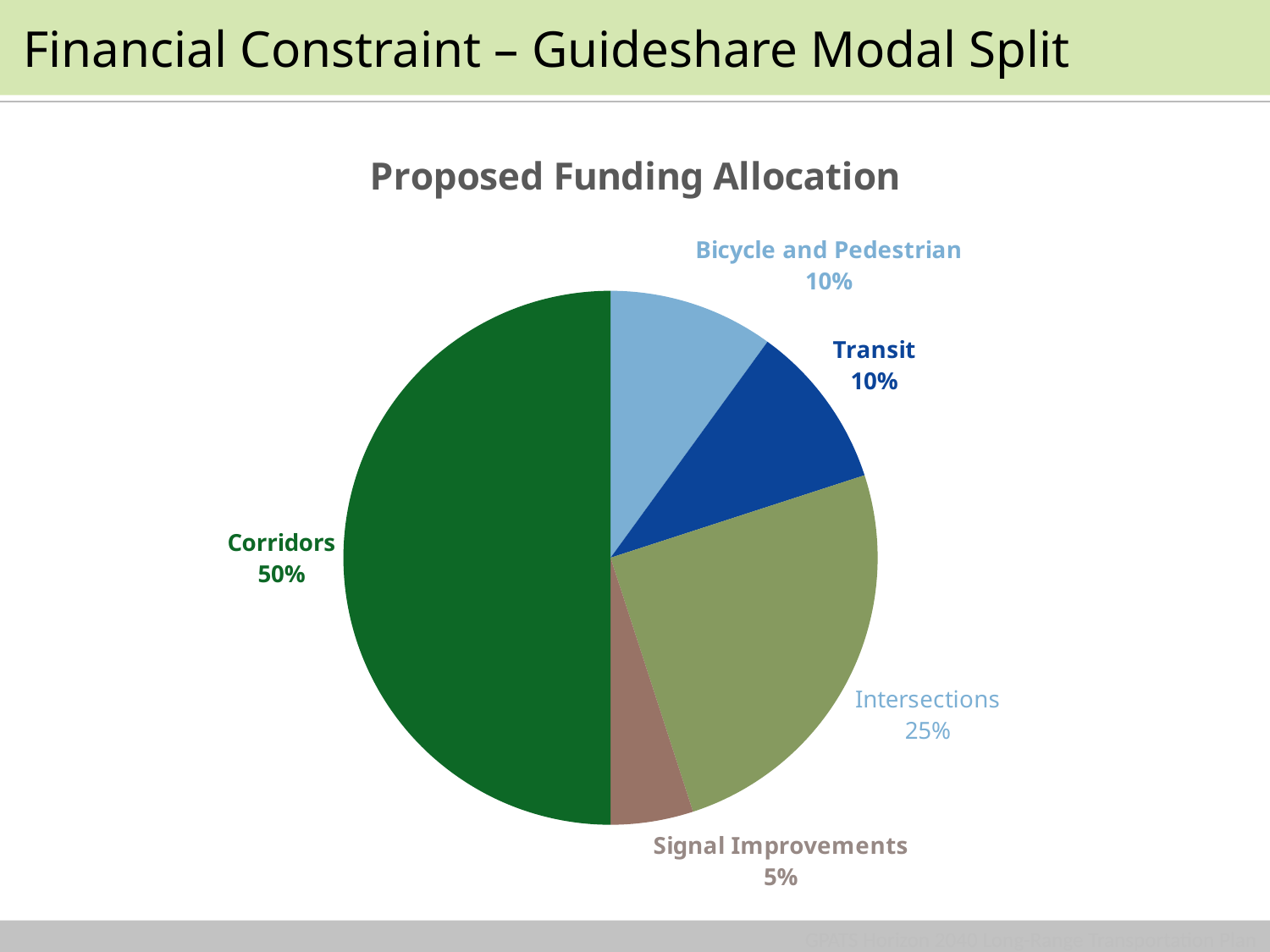
What share of the proposed funding is allocated to Intersections? 25% Which category receives the largest share of the proposed funding? Corridors What is the combined share of Bicycle and Pedestrian and Transit? 20% Which receives a larger share of funding, Intersections or Bicycle and Pedestrian? Intersections What type of chart is shown on the slide? Pie chart Which category receives the smallest share of the proposed funding? Signal Improvements What share of the proposed funding is allocated to Signal Improvements? 5% What is the title of the chart? Proposed Funding Allocation How many categories are shown in the pie chart? 5 What share of the proposed funding is allocated to Corridors? 50% What share of the proposed funding is allocated to Transit? 10% What is the difference in percentage points between the Corridors share and the Intersections share? 25